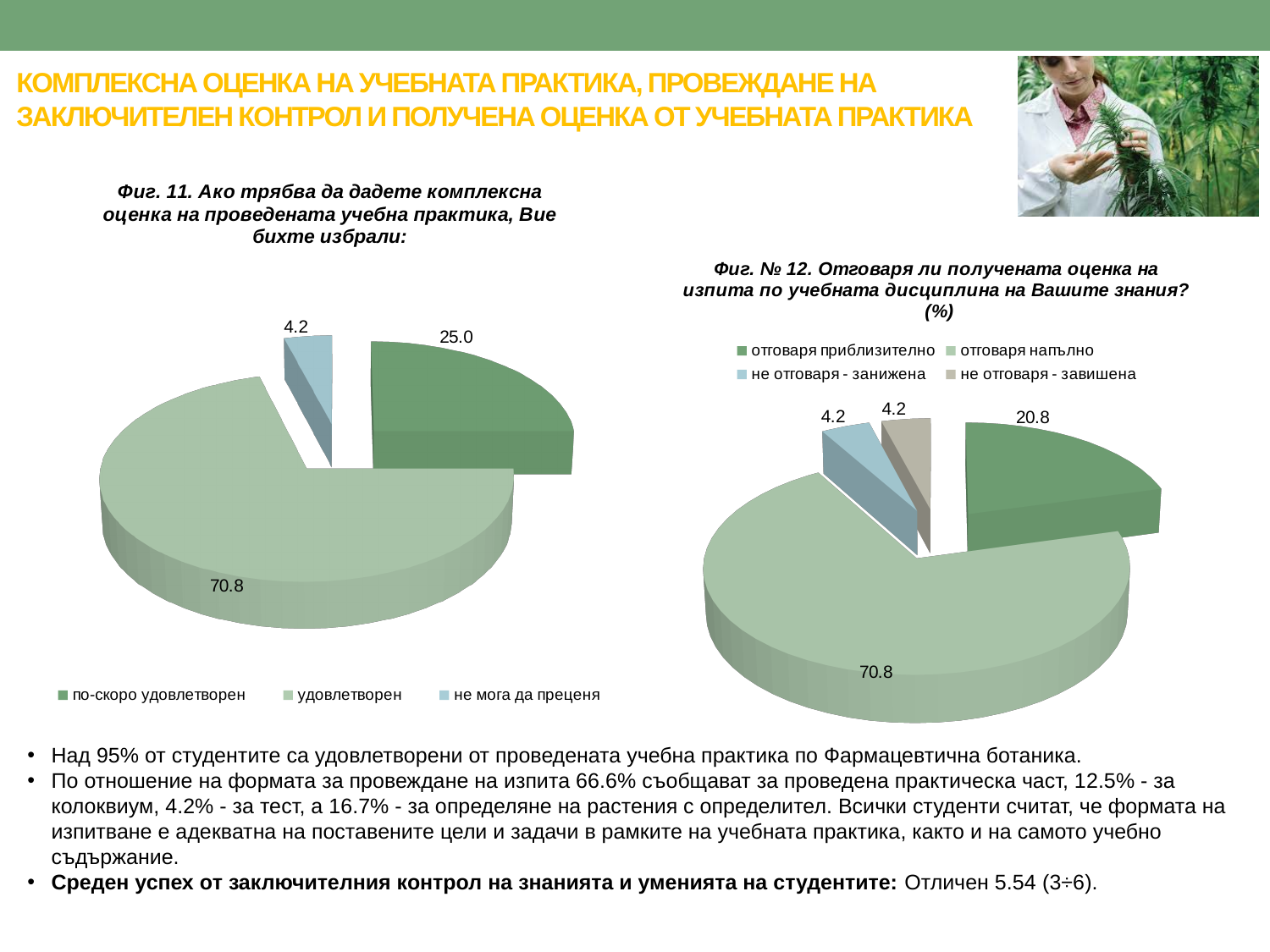
In the right chart (Фиг. № 12), what is the value for 'не отговаря - завишена'? 4.2 In the left chart (Фиг. 11), what is the value for 'по-скоро удовлетворен'? 25.0 In the right chart (Фиг. № 12), how many entries does the legend list? 4 In the left chart (Фиг. 11), what colour is the slice for 'не мога да преценя'? light blue In the left chart (Фиг. 11), how many slices does the pie have? 3 In the left chart (Фиг. 11), which category has the smallest slice? не мога да преценя In the right chart (Фиг. № 12), what is the value for 'отговаря приблизително'? 20.8 In the right chart (Фиг. № 12), which category has the largest slice? отговаря напълно In the left chart (Фиг. 11), what is the difference between the values for 'удовлетворен' and 'по-скоро удовлетворен'? 45.8 What kind of chart is Фиг. 11 on the left of the slide? pie chart In the left chart (Фиг. 11), what is the value for 'удовлетворен'? 70.8 In the right chart (Фиг. № 12), which is larger: 'отговаря приблизително' or 'не отговаря - занижена'? отговаря приблизително